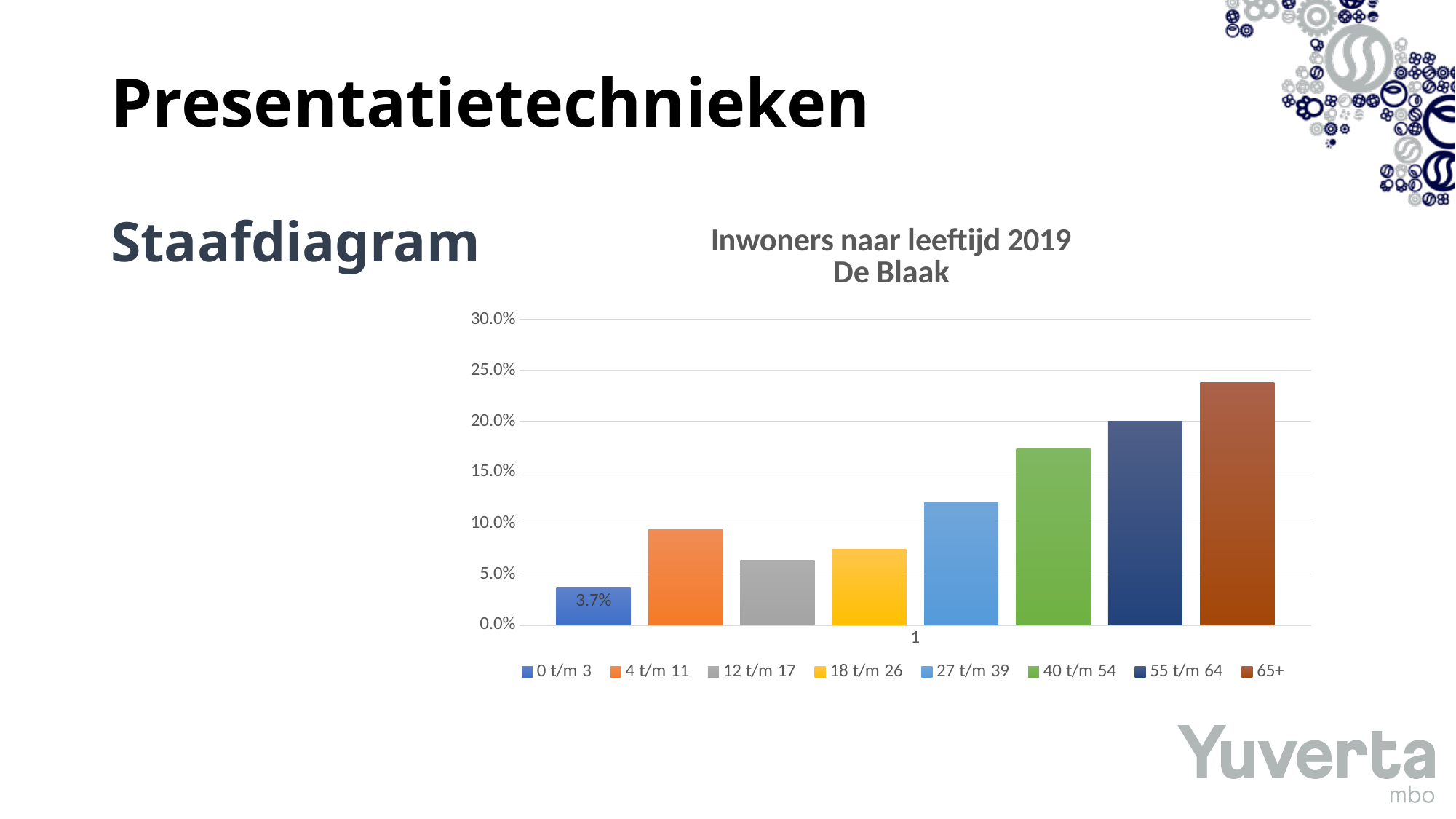
What kind of chart is shown on the slide? Bar chart How many bars are plotted in the chart? 8 What is the value shown for the 0 t/m 3 age group? 3.7% Which age group has the lowest bar? 0 t/m 3 Which age group has the highest bar? 65+ Is the value for 65+ greater or less than 20.0%? greater What is the title of the chart? Inwoners naar leeftijd 2019 De Blaak How many series does the legend list? 8 Is the value for 4 t/m 11 greater or less than 10.0%? less Is the value for 27 t/m 39 greater or less than 10.0%? greater Which is larger, the value for 55 t/m 64 or the value for 27 t/m 39? 55 t/m 64